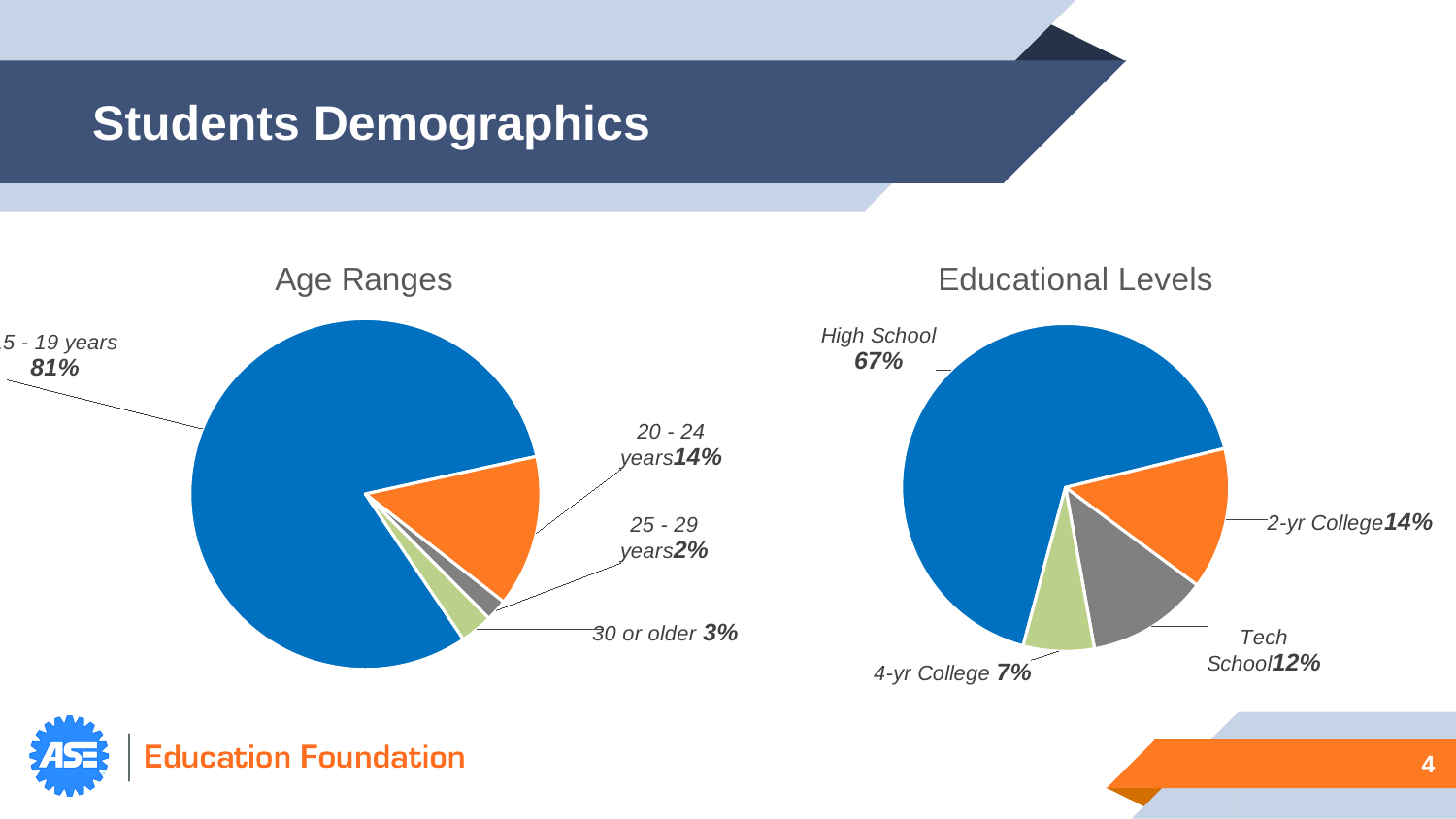
What is the title of the chart on the right side of the slide? Educational Levels In the Age Ranges chart, what share of students are 30 or older? 3% In the Educational Levels chart, what is the difference between the 2-yr College share and the 4-yr College share? 7% What type of chart is the Age Ranges chart? pie chart In the Age Ranges chart, what share of students are 20 - 24 years old? 14% In the Age Ranges chart, which is larger: the 25 - 29 years slice or the 30 or older slice? 30 or older In the Age Ranges chart, what is the share of the largest slice? 81% In the Educational Levels chart, what share of students are at Tech School? 12% In the Educational Levels chart, what share of students are at High School level? 67% In the Age Ranges chart, what share of students are 25 - 29 years old? 2% How many slices does the Age Ranges pie chart have? 4 In the Educational Levels chart, which category has the smallest share? 4-yr College